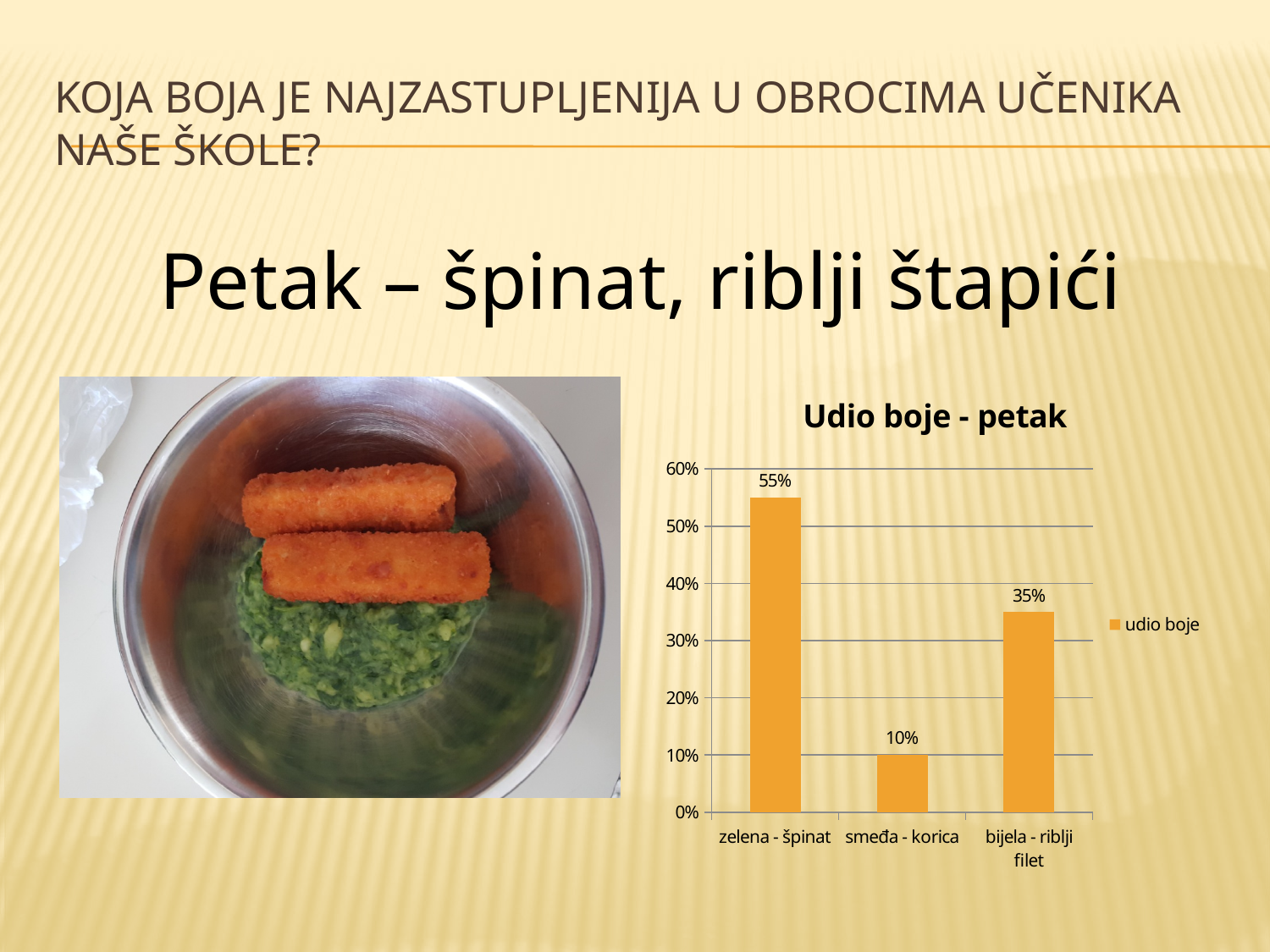
Which category has the highest value? zelena - špinat What is the value for zelena - špinat? 55% Which is larger, the value for smeđa - korica or the value for bijela - riblji filet? bijela - riblji filet What kind of chart is shown? bar chart What is the title of the chart? Udio boje - petak What is the value for bijela - riblji filet? 35% Is the value for zelena - špinat greater or less than 50%? greater Which category has the lowest value? smeđa - korica What is the difference between the values for zelena - špinat and bijela - riblji filet? 20% What is the difference between the values for bijela - riblji filet and smeđa - korica? 25% What is the value for smeđa - korica? 10% How many categories are shown on the x axis? 3